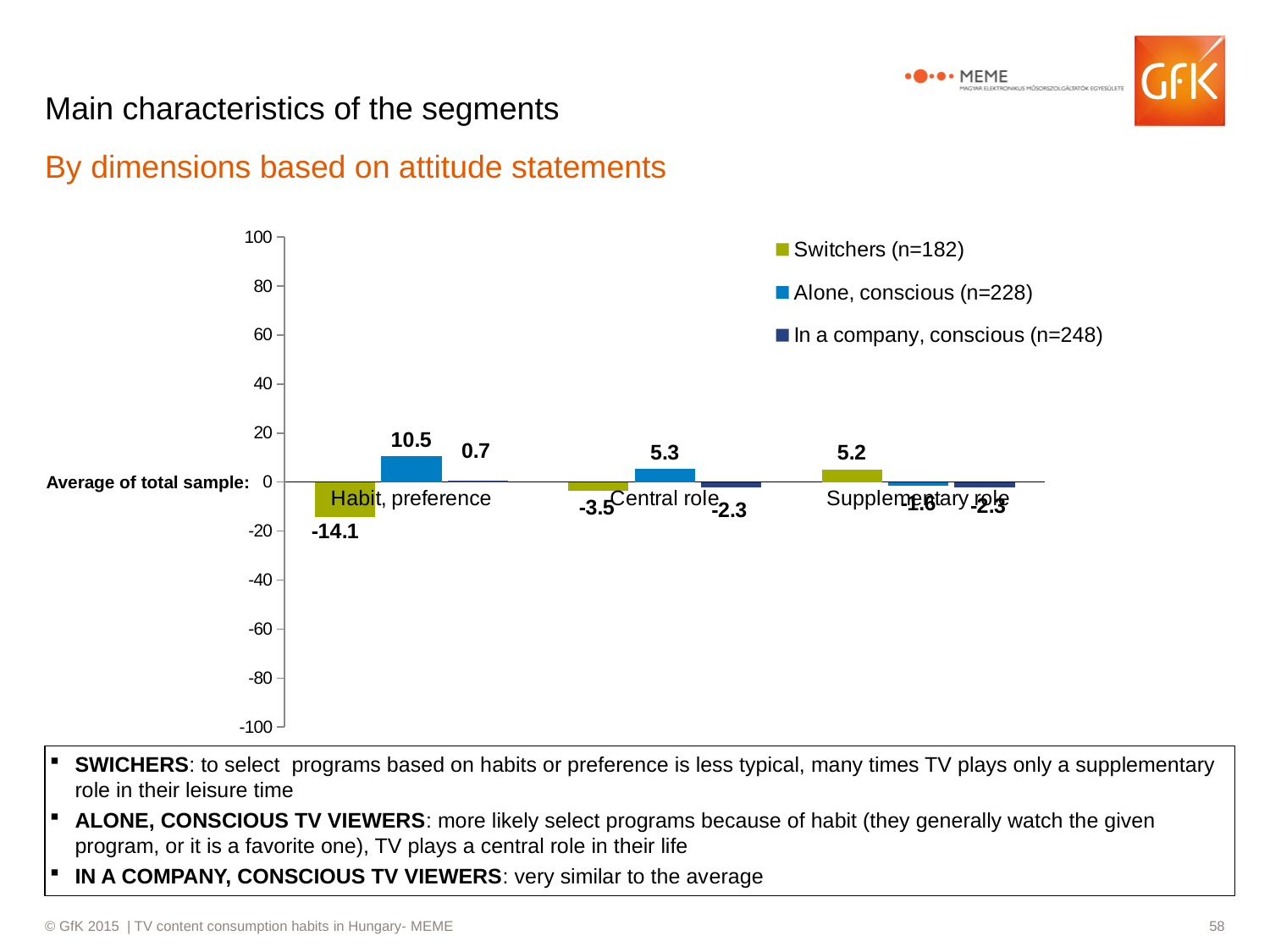
What is the difference between the Alone, conscious (n=228) value and the Switchers (n=182) value in the Habit, preference category? 24.6 Which series has the lowest value in the Habit, preference category? Switchers (n=182) Which series has the highest value in the Central role category? Alone, conscious (n=228) What kind of chart is shown on the slide? Bar chart How many series does the legend list? 3 What is the value for Alone, conscious (n=228) in the Habit, preference category? 10.5 What is the value for Switchers (n=182) in the Supplementary role category? 5.2 Which is larger in the Central role category: the value for Alone, conscious (n=228) or the value for In a company, conscious (n=248)? Alone, conscious (n=228) What is the value for Switchers (n=182) in the Central role category? -3.5 What is the value for Alone, conscious (n=228) in the Central role category? 5.3 What is the value for In a company, conscious (n=248) in the Habit, preference category? 0.7 What is the value for Switchers (n=182) in the Habit, preference category? -14.1